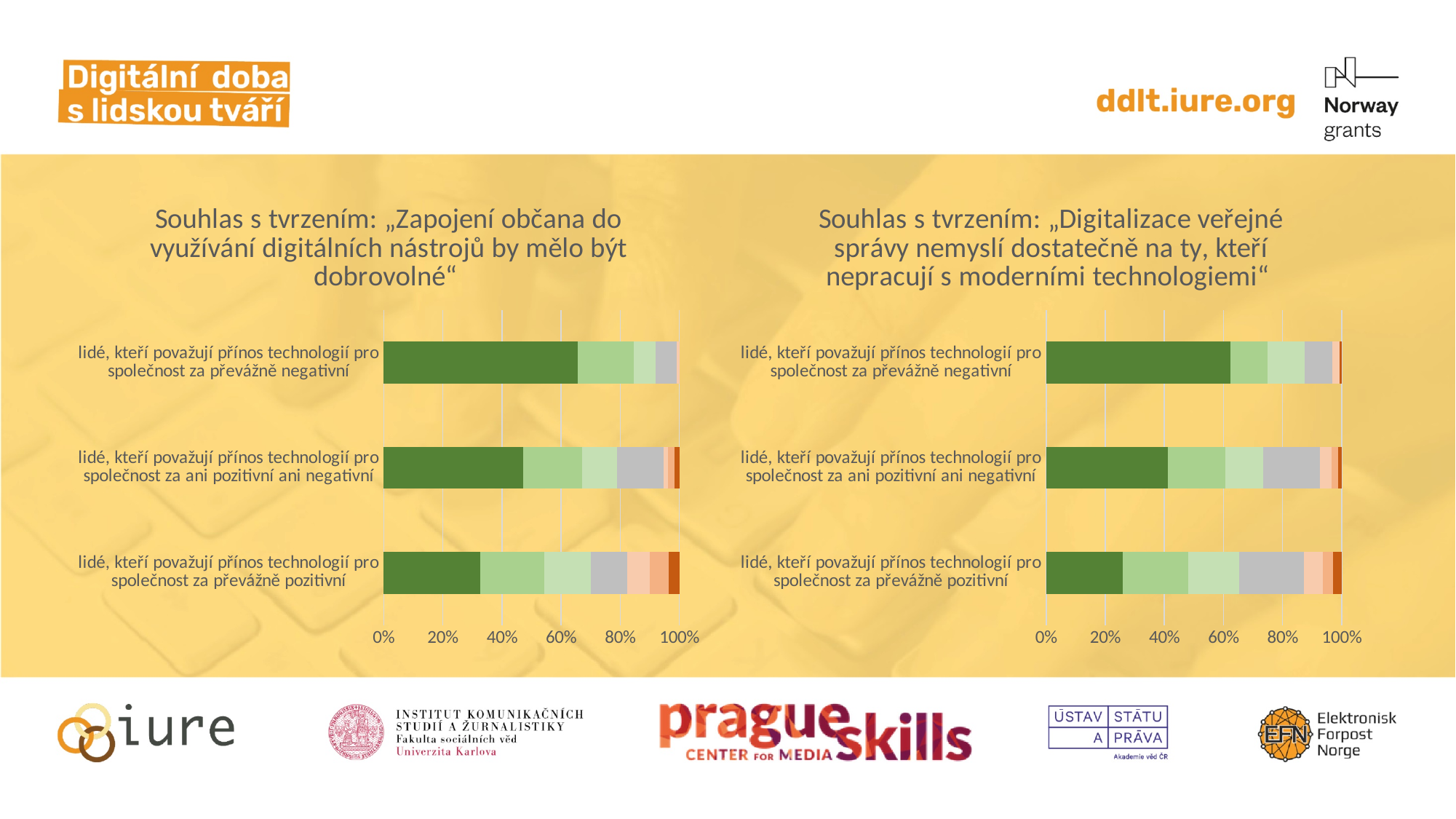
On the left chart, does the dark green segment get larger or smaller going from the top category to the bottom category? smaller On the right chart, which category has the smallest dark green segment? lidé, kteří považují přínos technologií pro společnost za převážně pozitivní On the left chart, which category has the largest dark green segment? lidé, kteří považují přínos technologií pro společnost za převážně negativní What kind of chart is the left chart on the slide? bar chart On the left chart, is the dark green segment for 'lidé, kteří považují přínos technologií pro společnost za ani pozitivní ani negativní' greater or less than 40%? greater On the right chart, is the dark green segment for 'lidé, kteří považují přínos technologií pro společnost za převážně pozitivní' greater or less than 40%? less On the right chart, which category has a larger dark green segment: 'převážně negativní' or 'převážně pozitivní'? převážně negativní On the right chart, is the dark green segment for 'lidé, kteří považují přínos technologií pro společnost za převážně negativní' greater or less than 40%? greater How many categories are shown on the right chart? 3 What is the highest value shown on the x axis of the right chart? 100%